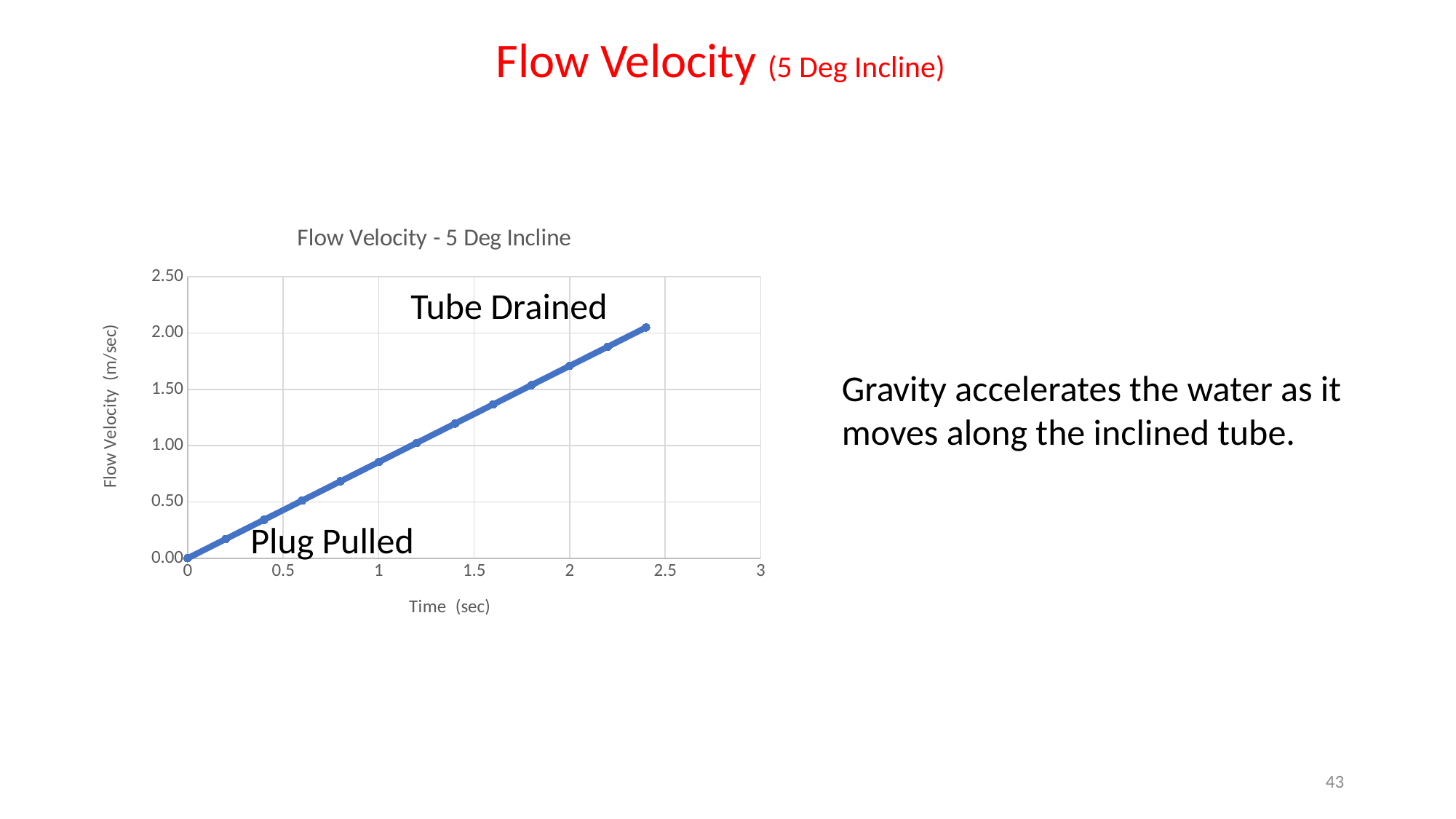
How many data points are plotted on the chart? 13 Does the flow velocity rise or fall as time increases? rise What is the flow velocity at time 0 sec? 0.00 What kind of chart is shown on the slide? line chart At which time is the flow velocity lowest? 0 sec What is the title of the chart? Flow Velocity - 5 Deg Incline Is the flow velocity at 2.4 sec greater or less than 2.00? greater Is the flow velocity at 1 sec greater or less than 1.00? less At which time is the flow velocity highest? 2.4 sec Is the flow velocity at 0.4 sec greater or less than 0.50? less What is the label of the vertical axis? Flow Velocity (m/sec)